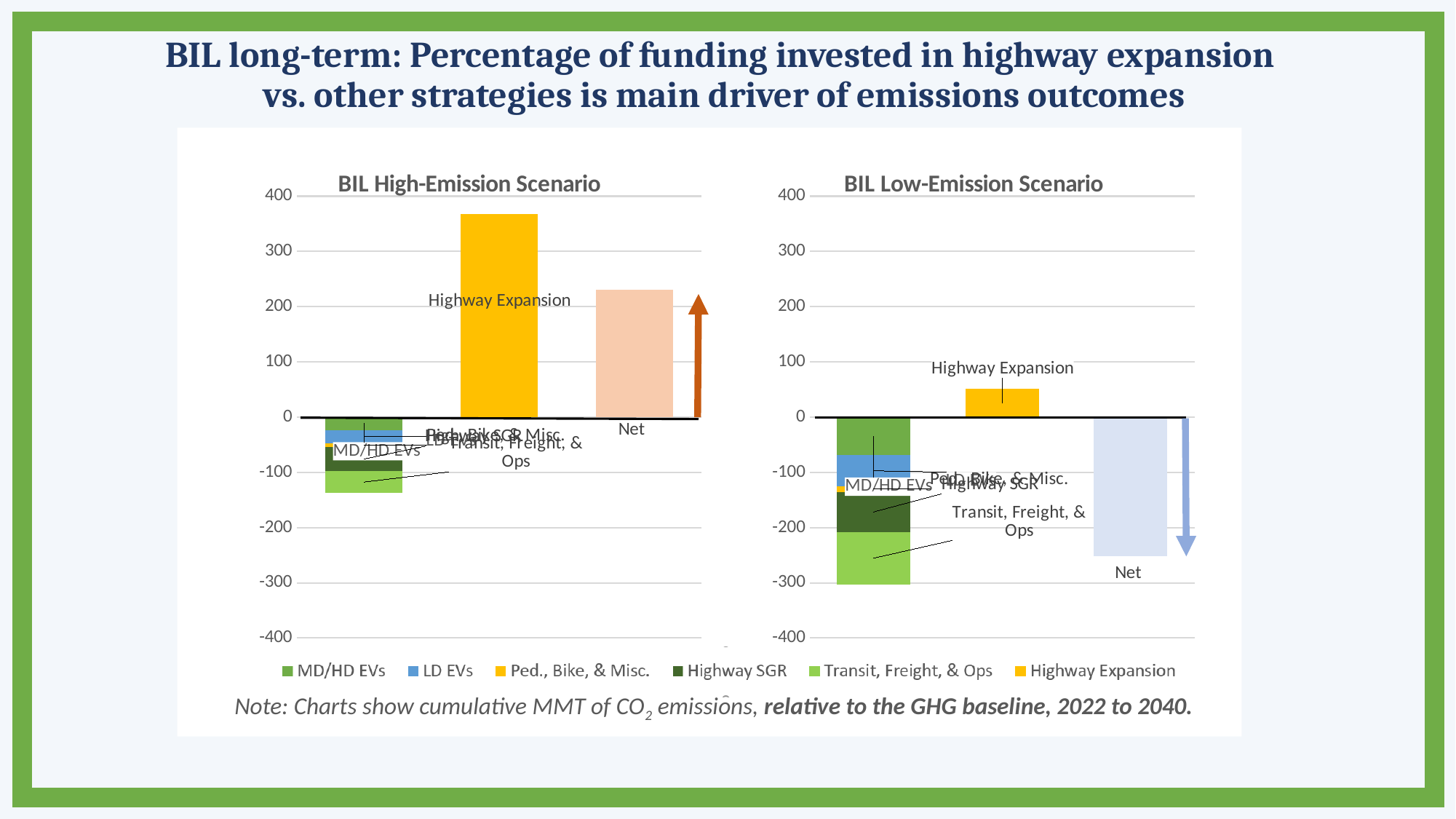
What is the highest value shown on the vertical axis of the BIL High-Emission Scenario chart? 400 Which chart shows a larger Highway Expansion value, BIL High-Emission Scenario or BIL Low-Emission Scenario? BIL High-Emission Scenario What is the title of the chart on the right side of the slide? BIL Low-Emission Scenario In the BIL High-Emission Scenario chart, is the Net value greater or less than 200? greater In the BIL High-Emission Scenario chart, which labelled bar is the highest? Highway Expansion In the BIL High-Emission Scenario chart, is the value for Highway Expansion greater or less than 300? greater How many series does the shared legend below the charts list? 6 In the BIL Low-Emission Scenario chart, is the Net value greater or less than -200? less Which legend entry is shown in dark green? Highway SGR What kind of chart is the BIL High-Emission Scenario chart? bar chart In the BIL Low-Emission Scenario chart, is the Net value positive or negative? negative